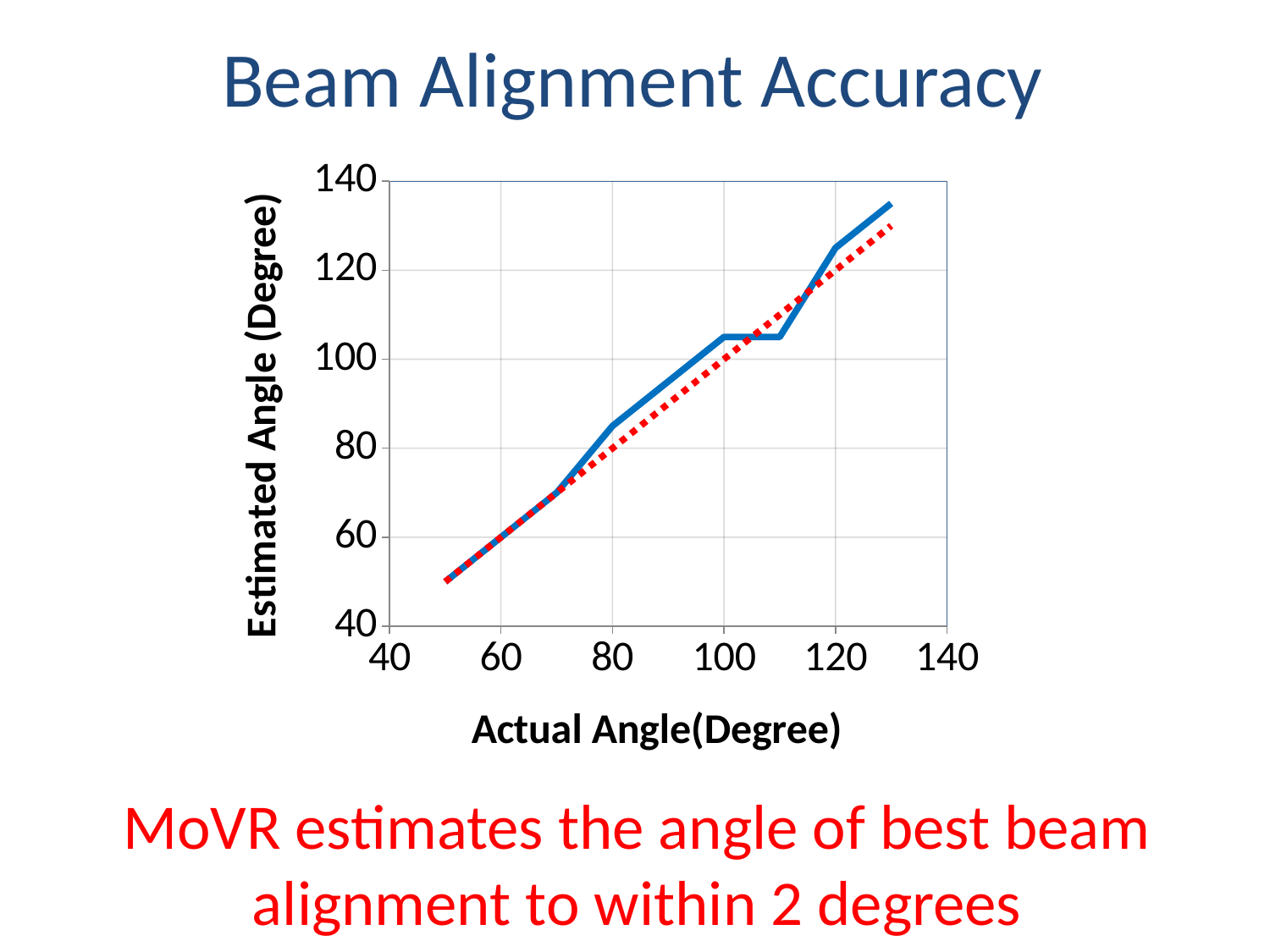
What is the title of the chart on the slide? Beam Alignment Accuracy At which actual angle does the solid blue line have its lowest estimated angle? 50 What is the label of the x axis? Actual Angle(Degree) Is the value of the solid blue line at an actual angle of 50 degrees greater or less than 60? less At which actual angle does the solid blue line reach its highest estimated angle? 130 At an actual angle of 80 degrees, which line is higher, the solid blue line or the dotted red line? solid blue line Is the value of the solid blue line at an actual angle of 80 degrees greater or less than 80? greater Is the value of the solid blue line at an actual angle of 130 degrees greater or less than 140? less What kind of chart is shown on the slide? line chart Does the solid blue line rise or fall as the actual angle increases from 50 to 130 degrees? rise At an actual angle of 110 degrees, which line is higher, the solid blue line or the dotted red line? dotted red line